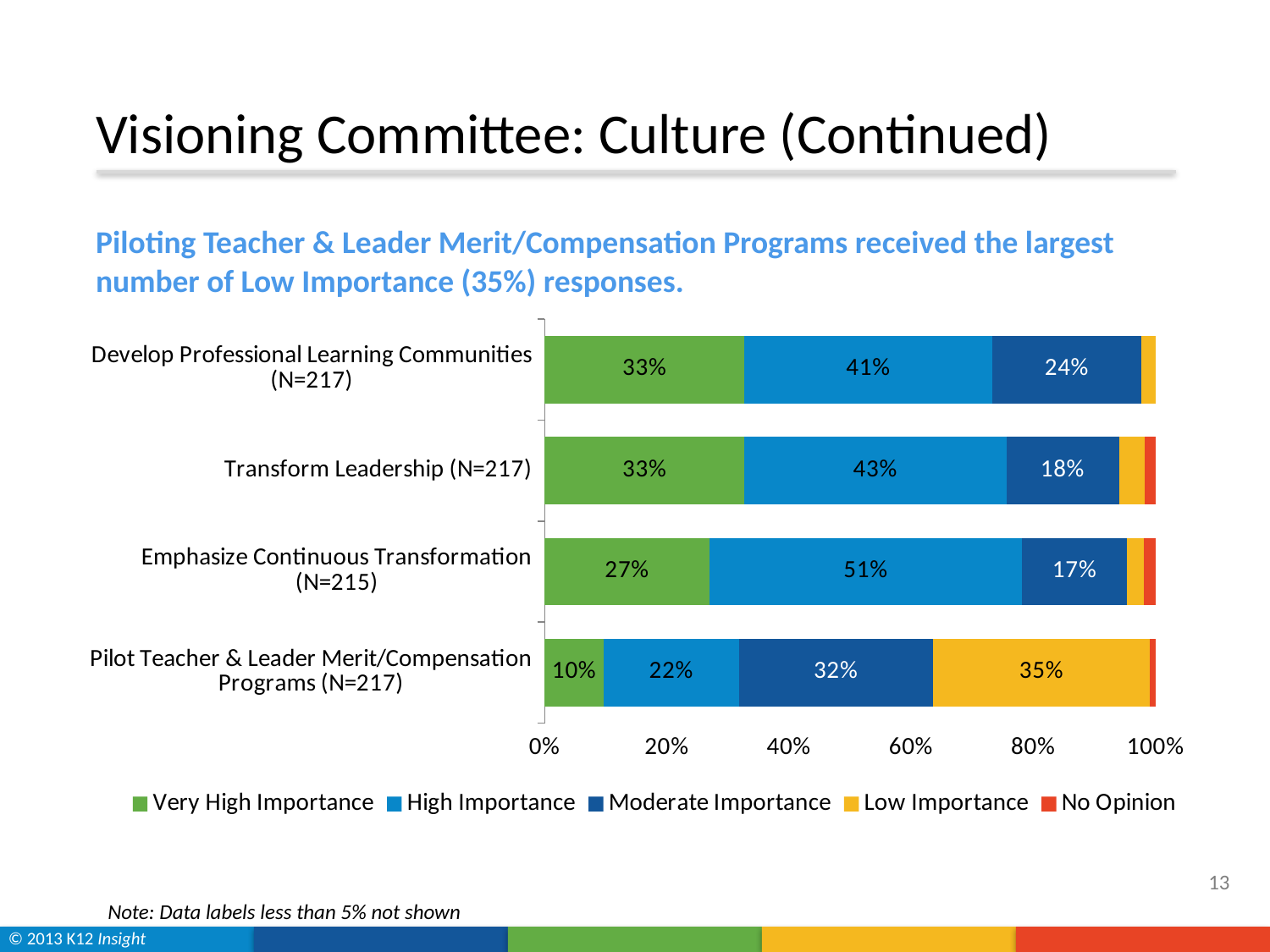
What kind of chart is shown on the slide? Stacked bar chart How many categories are shown on the chart? 4 Which category has the lowest Very High Importance value? Pilot Teacher & Leader Merit/Compensation Programs Which category has the highest High Importance value? Emphasize Continuous Transformation What is the Moderate Importance value for Transform Leadership? 18% Which has a larger High Importance value, Transform Leadership or Develop Professional Learning Communities? Transform Leadership What is the High Importance value for Emphasize Continuous Transformation? 51% What is the difference in percentage points between the Moderate Importance values for Pilot Teacher & Leader Merit/Compensation Programs and Emphasize Continuous Transformation? 15 How many series does the legend list? 5 What is the Low Importance value for Pilot Teacher & Leader Merit/Compensation Programs? 35% What percentage of respondents rated Develop Professional Learning Communities as Very High Importance? 33% What is the difference in percentage points between the High Importance values for Emphasize Continuous Transformation and Develop Professional Learning Communities? 10